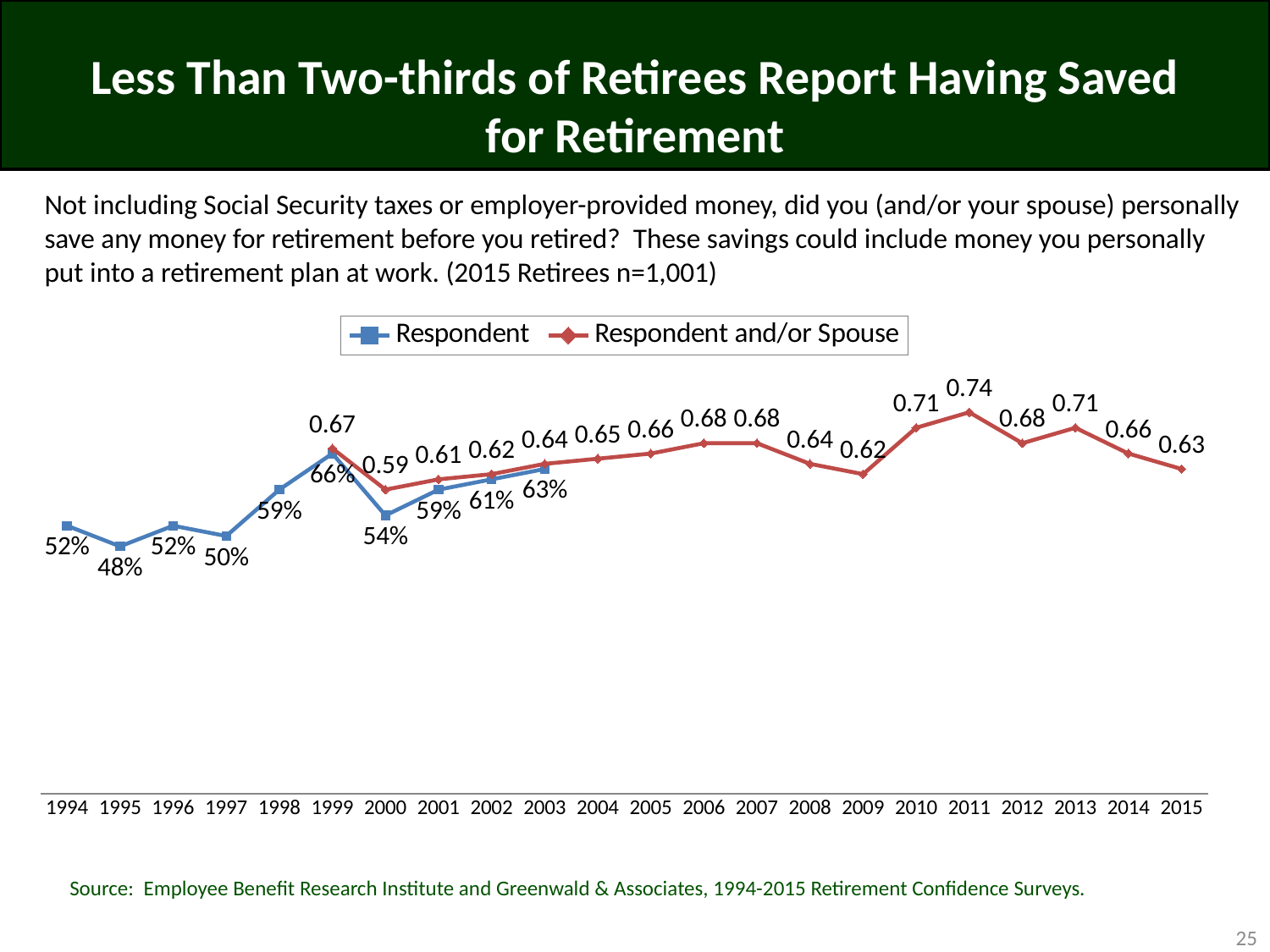
What is the value for Respondent and/or Spouse in 2015? 0.63 In which year is the Respondent and/or Spouse series highest? 2011 What kind of chart is shown on the slide? line chart Does the Respondent and/or Spouse series rise or fall from 2013 to 2015? fall How many series does the legend list? 2 In which year is the Respondent series highest? 1999 In 2003, which series has the larger value, Respondent or Respondent and/or Spouse? Respondent and/or Spouse What is the value for Respondent in 1995? 48% What is the difference between the Respondent values for 1999 and 2000? 12% In which year is the Respondent series lowest? 1995 How many years are shown on the x axis? 22 What is the value for Respondent and/or Spouse in 2011? 0.74